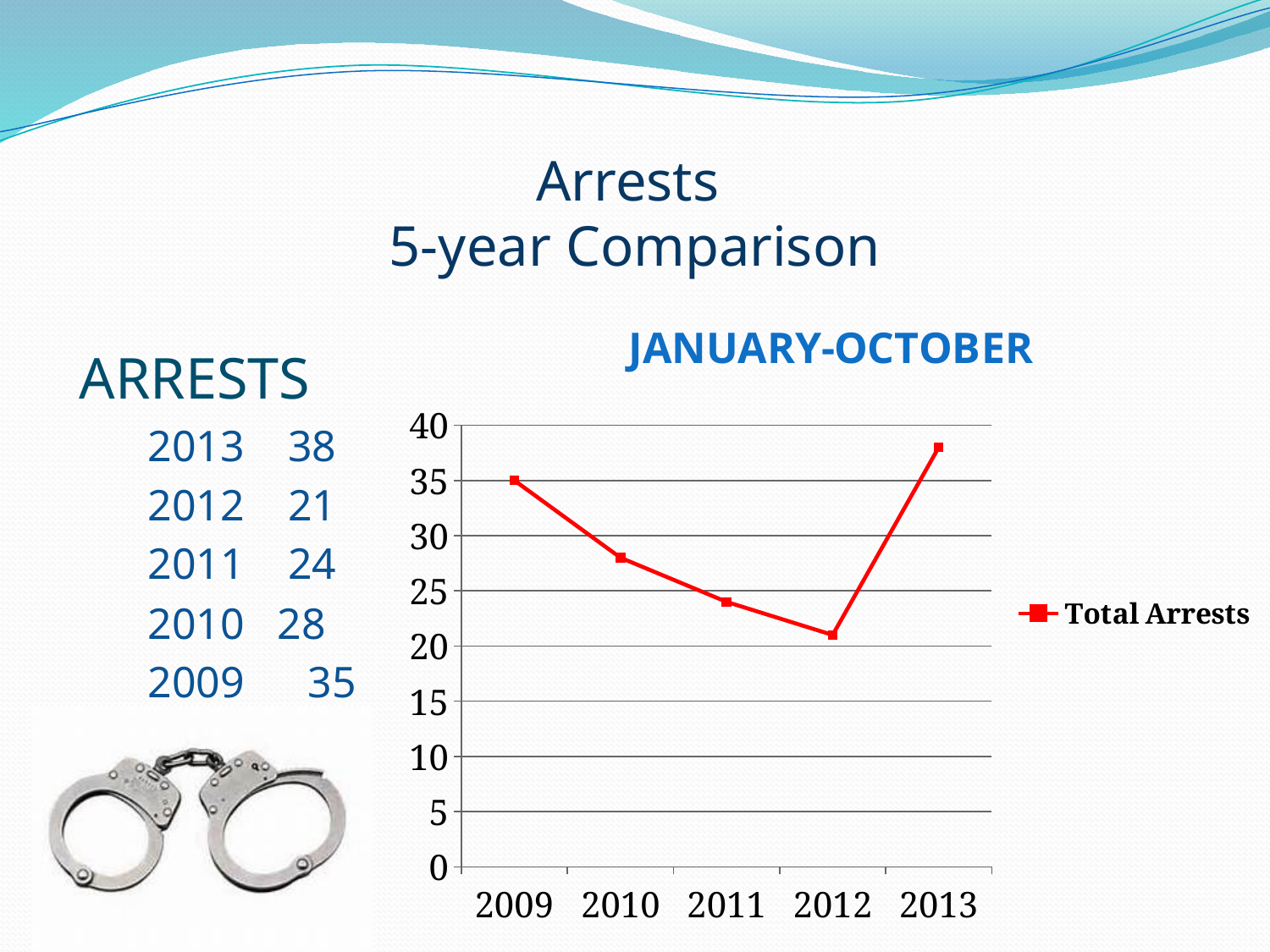
Is the value for Total Arrests in 2010 greater or less than 25? greater How many years are plotted on the x axis of the chart? 5 What is the title of the chart? JANUARY-OCTOBER How many series does the chart legend list? 1 Which year has the highest number of Total Arrests? 2013 What is the difference in Total Arrests between 2013 and 2012? 17 Which year has the lowest number of Total Arrests? 2012 What kind of chart is shown on the slide? line chart What is the value of Total Arrests for 2009? 35 What is the value of Total Arrests for 2013? 38 What is the name of the series shown in the legend? Total Arrests What is the value of Total Arrests for 2012? 21